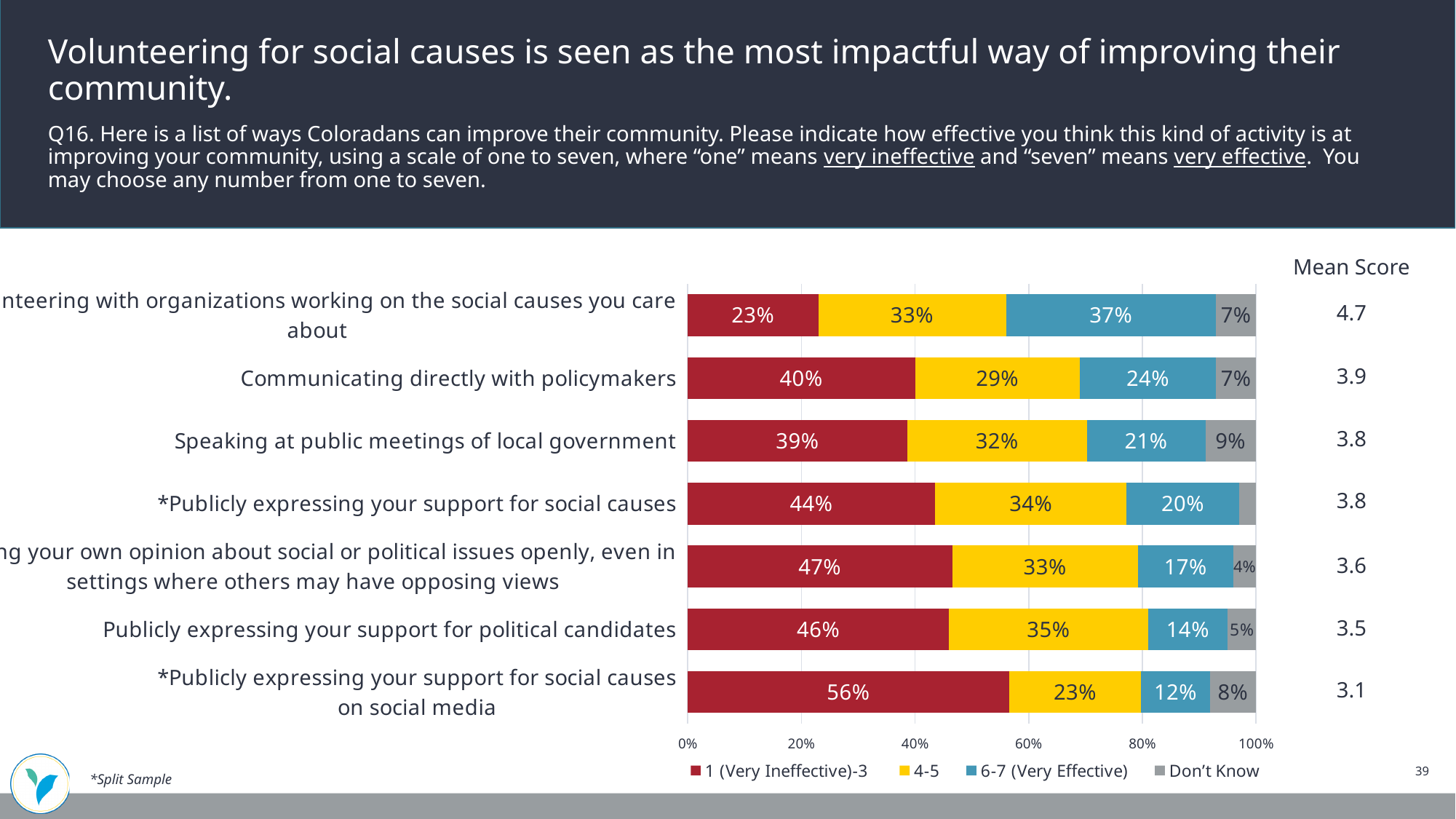
How many activities are shown in the chart? 7 What percentage rated 'Publicly expressing your support for social causes on social media' as 1 (Very Ineffective)-3? 56% Which activity has the lowest share of 6-7 (Very Effective) ratings? Publicly expressing your support for social causes on social media What is the total of the four segments for 'Communicating directly with policymakers'? 100% Which activity has the highest share of 6-7 (Very Effective) ratings? Volunteering with organizations working on the social causes you care about Which activity has the highest share of 1 (Very Ineffective)-3 ratings? Publicly expressing your support for social causes on social media Which has a larger 4-5 share: 'Publicly expressing your support for political candidates' or 'Speaking at public meetings of local government'? Publicly expressing your support for political candidates What is the difference in the 1 (Very Ineffective)-3 share between 'Publicly expressing your support for social causes on social media' and 'Volunteering with organizations working on the social causes you care about'? 33 percentage points What is the Mean Score shown for 'Volunteering with organizations working on the social causes you care about'? 4.7 What percentage rated 'Communicating directly with policymakers' as 6-7 (Very Effective)? 24% What type of chart is shown on the slide? Stacked bar chart How many series does the legend list? 4